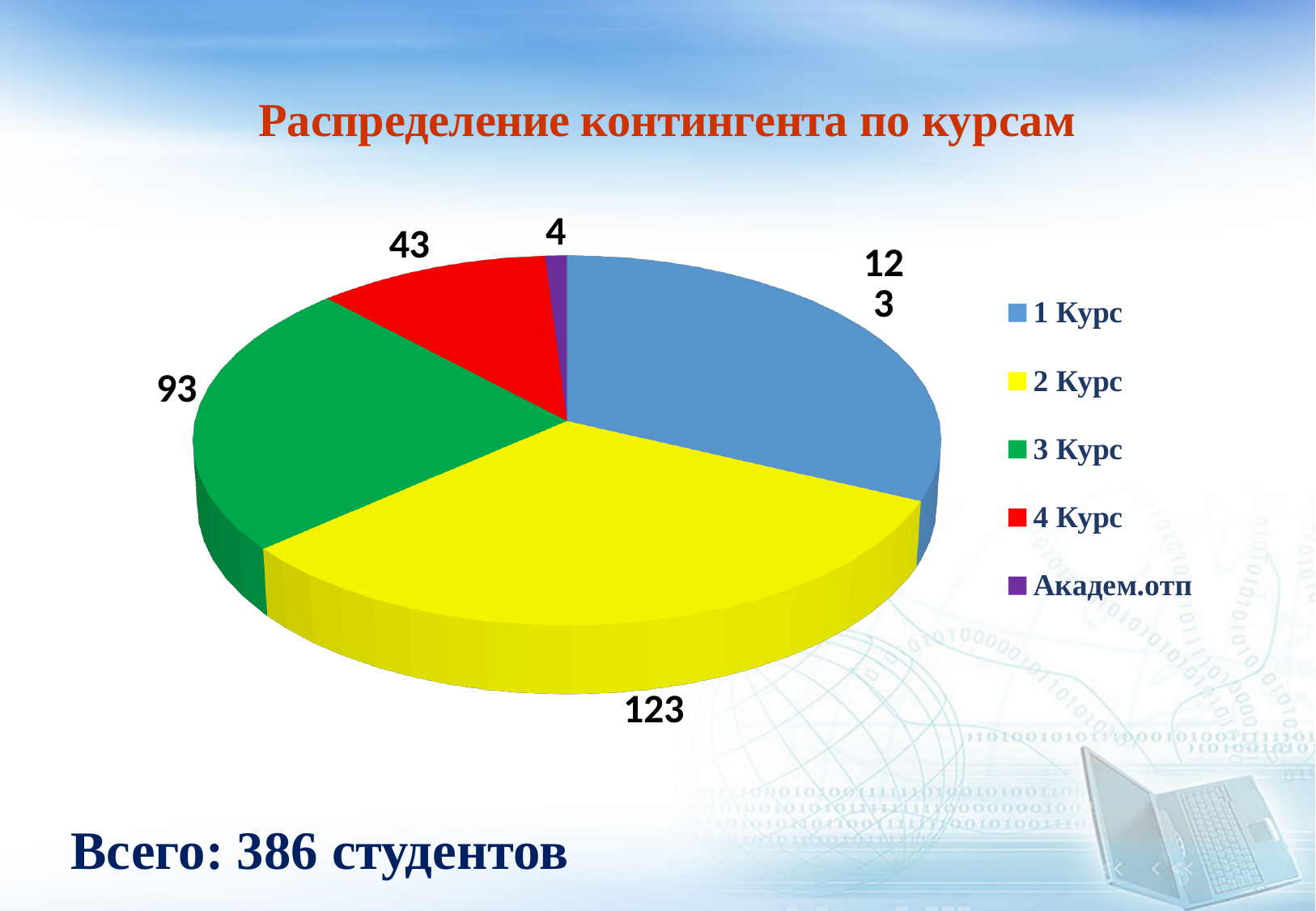
What is the difference between the values for 3 Курс and 4 Курс? 50 What is the value for 2 Курс in the pie chart? 123 Which category has the smallest slice in the pie chart? Академ.отп What is the title of the chart? Распределение контингента по курсам What is the value for 3 Курс in the pie chart? 93 What kind of chart is shown on the slide? Pie chart What is the value for 4 Курс in the pie chart? 43 How many categories does the pie chart show? 5 Which is larger, the value for 3 Курс or the value for 4 Курс? 3 Курс What is the value for Академ.отп in the pie chart? 4 What colour is the slice for 3 Курс? Green What is the value for 1 Курс in the pie chart? 123